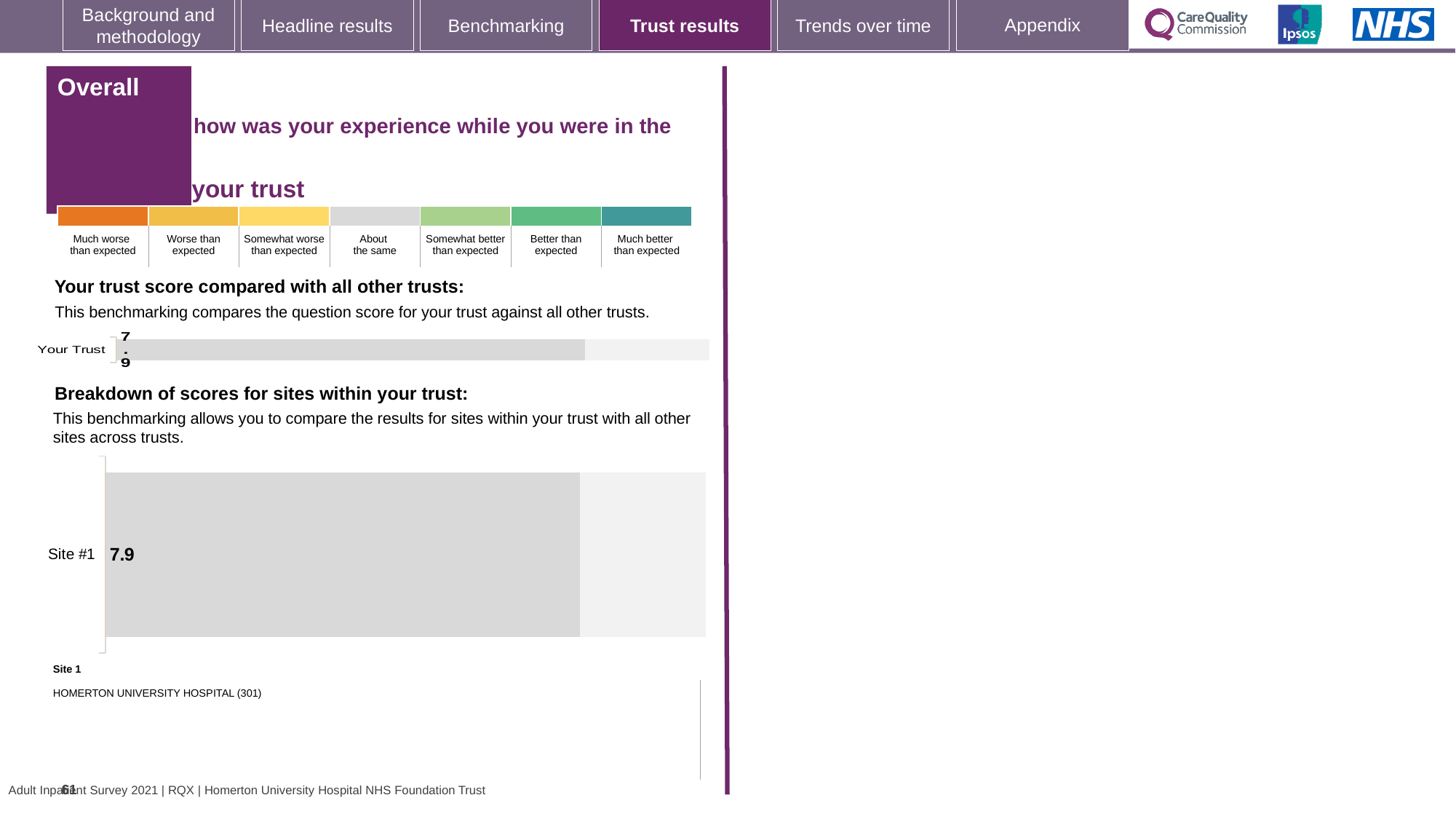
What kind of chart is the 'Your trust score compared with all other trusts' chart? bar chart In the 'Breakdown of scores for sites within your trust' chart, what is the score shown for Site #1? 7.9 How many bars are plotted in the 'Your trust score compared with all other trusts' chart? 1 What kind of chart is the 'Breakdown of scores for sites within your trust' chart? bar chart What is the difference between the Your Trust score and the Site #1 score on this slide? 0.0 In the 'Your trust score compared with all other trusts' chart, what is the score shown for Your Trust? 7.9 In the 'Breakdown of scores for sites within your trust' chart, which hospital is listed as Site 1? HOMERTON UNIVERSITY HOSPITAL (301) How many sites are plotted in the 'Breakdown of scores for sites within your trust' chart? 1 What is the category label of the single bar in the 'Your trust score compared with all other trusts' chart? Your Trust